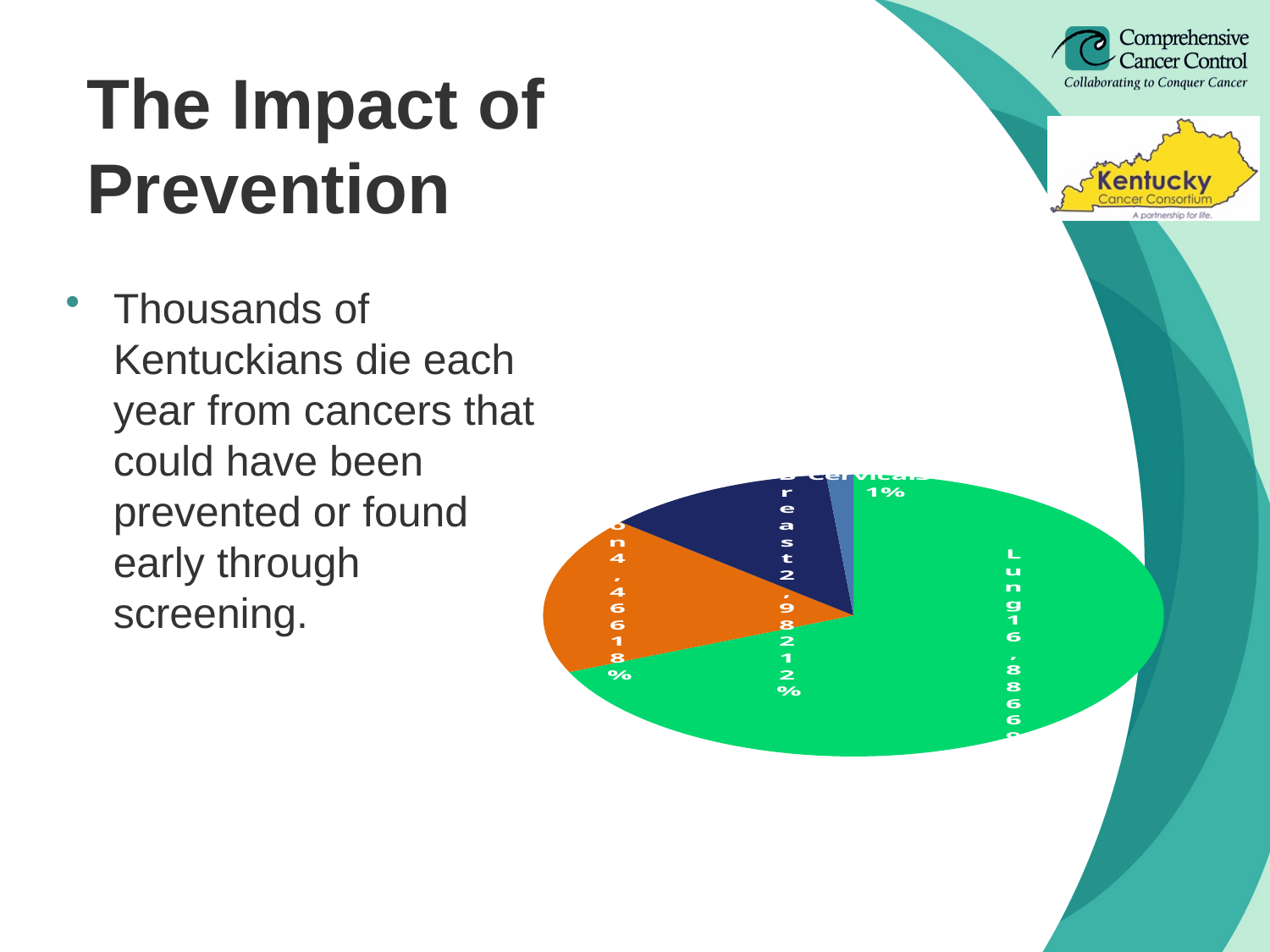
What colour is the Lung slice in the pie chart? green What is the difference between the Lung value and the Breast value in the pie chart? 13,904 Which category has the smallest slice of the pie chart? Cervical What share of the pie does Breast represent? 12% How many slices does the pie chart have? 4 What value is shown for Lung in the pie chart? 16,886 What value is shown for Breast in the pie chart? 2,982 Which is larger in the pie chart, Breast or Cervical? Breast What kind of chart is shown on the slide? pie chart What share of the pie does Cervical represent? 1% What share of the pie does the orange slice represent? 18% Which category has the largest slice of the pie chart? Lung